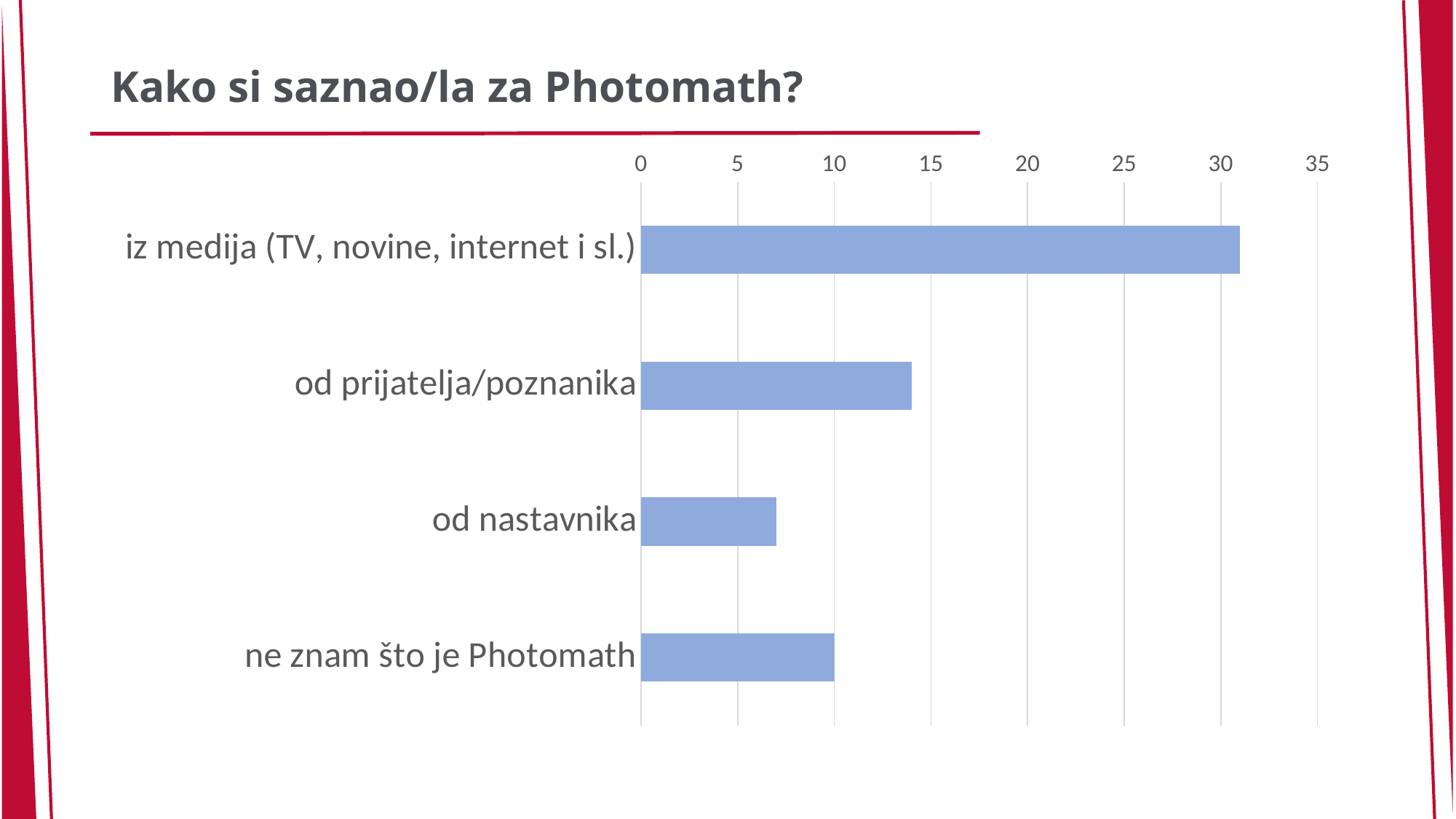
Which is larger: the value for "od prijatelja/poznanika" or the value for "ne znam što je Photomath"? od prijatelja/poznanika Is the value for "od nastavnika" greater or less than 5? greater Is the value for "od nastavnika" greater or less than 10? less Which category has the highest value? iz medija (TV, novine, internet i sl.) Which category has the lowest value? od nastavnika What is the value for "ne znam što je Photomath"? 10 Is the value for "od prijatelja/poznanika" greater or less than 15? less What kind of chart is shown on the slide? bar chart How many categories are shown in the chart? 4 What is the title of the chart on the slide? Kako si saznao/la za Photomath?